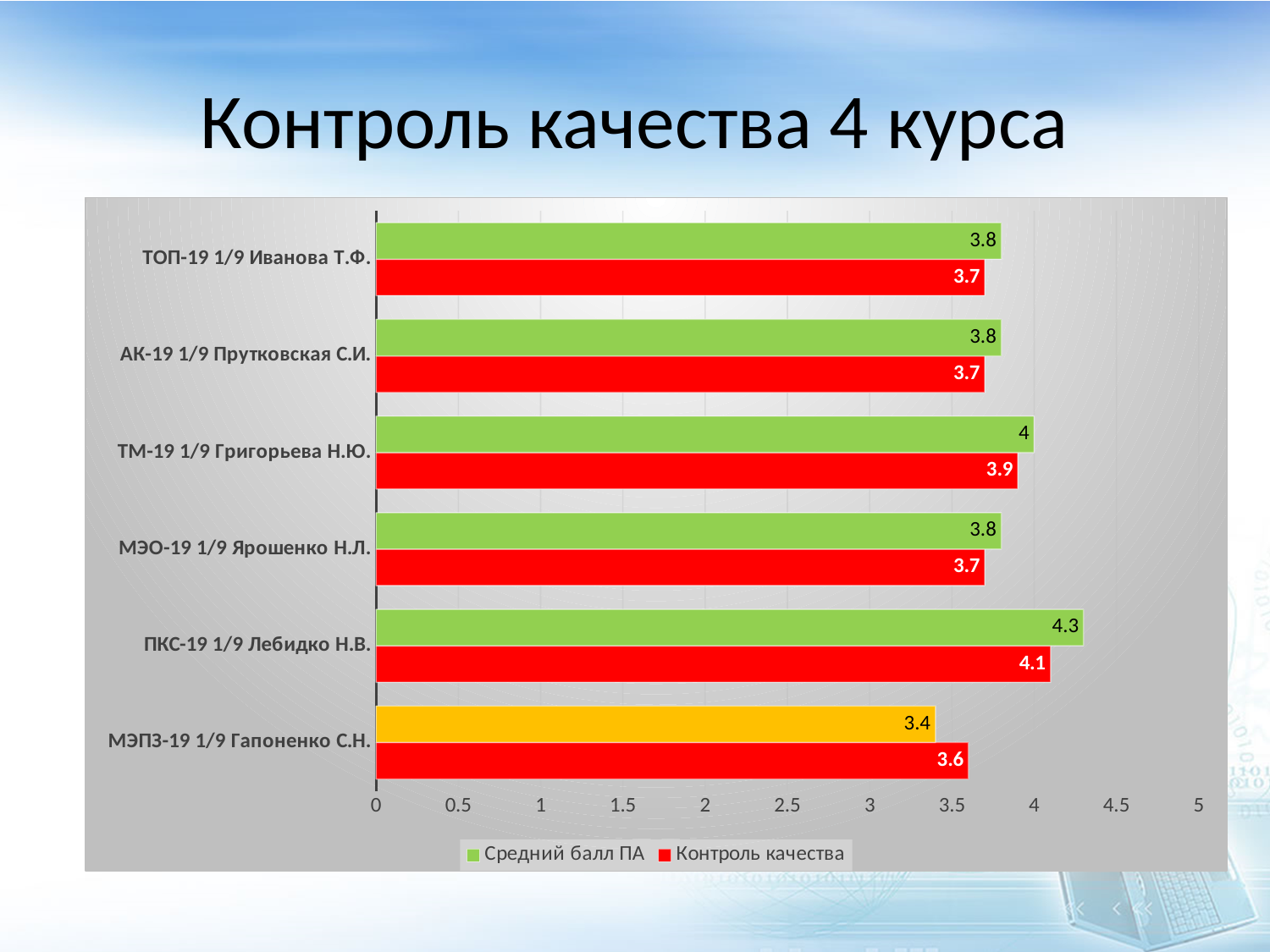
Which category has the lowest value for Контроль качества? МЭПЗ-19 1/9 Гапоненко С.Н. What is the value of Контроль качества for ТМ-19 1/9 Григорьева Н.Ю.? 3.9 How many categories are shown on the chart? 6 What kind of chart is shown on the slide? bar chart How many series does the legend list? 2 Is the value of Средний балл ПА for ТОП-19 1/9 Иванова Т.Ф. greater or less than 3.5? greater For МЭПЗ-19 1/9 Гапоненко С.Н., which is larger: Средний балл ПА or Контроль качества? Контроль качества Which category has the highest value for Средний балл ПА? ПКС-19 1/9 Лебидко Н.В. What is the value of Средний балл ПА for ПКС-19 1/9 Лебидко Н.В.? 4.3 What is the difference between Средний балл ПА and Контроль качества for ПКС-19 1/9 Лебидко Н.В.? 0.2 What is the title of the slide? Контроль качества 4 курса What is the value of Контроль качества for МЭПЗ-19 1/9 Гапоненко С.Н.? 3.6